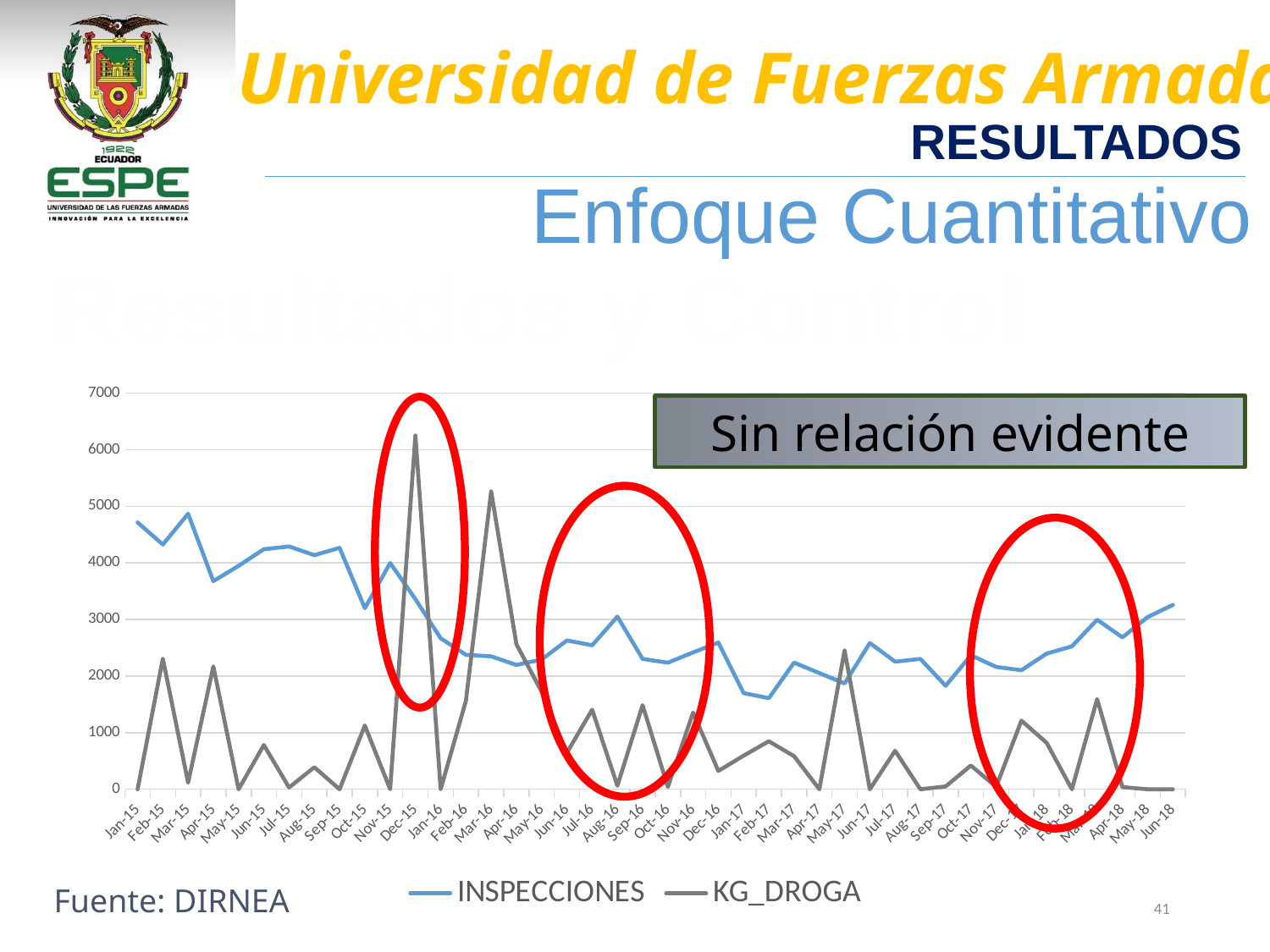
In Jan-15, which series has the larger value, INSPECCIONES or KG_DROGA? INSPECCIONES Which series is drawn in blue? INSPECCIONES What is the highest value shown on the vertical axis? 7000 In which month does KG_DROGA reach its highest value? Dec-15 How many series does the legend list? 2 Is the value of INSPECCIONES in Feb-17 greater or less than 2000? less Does the INSPECCIONES series generally rise or fall from Jan-15 to Dec-16? Fall What are the two series named in the legend? INSPECCIONES and KG_DROGA Is the value of INSPECCIONES in Jan-15 greater or less than 4000? greater Is the value of KG_DROGA in Mar-16 greater or less than 5000? greater What kind of chart is shown on the slide? Line chart